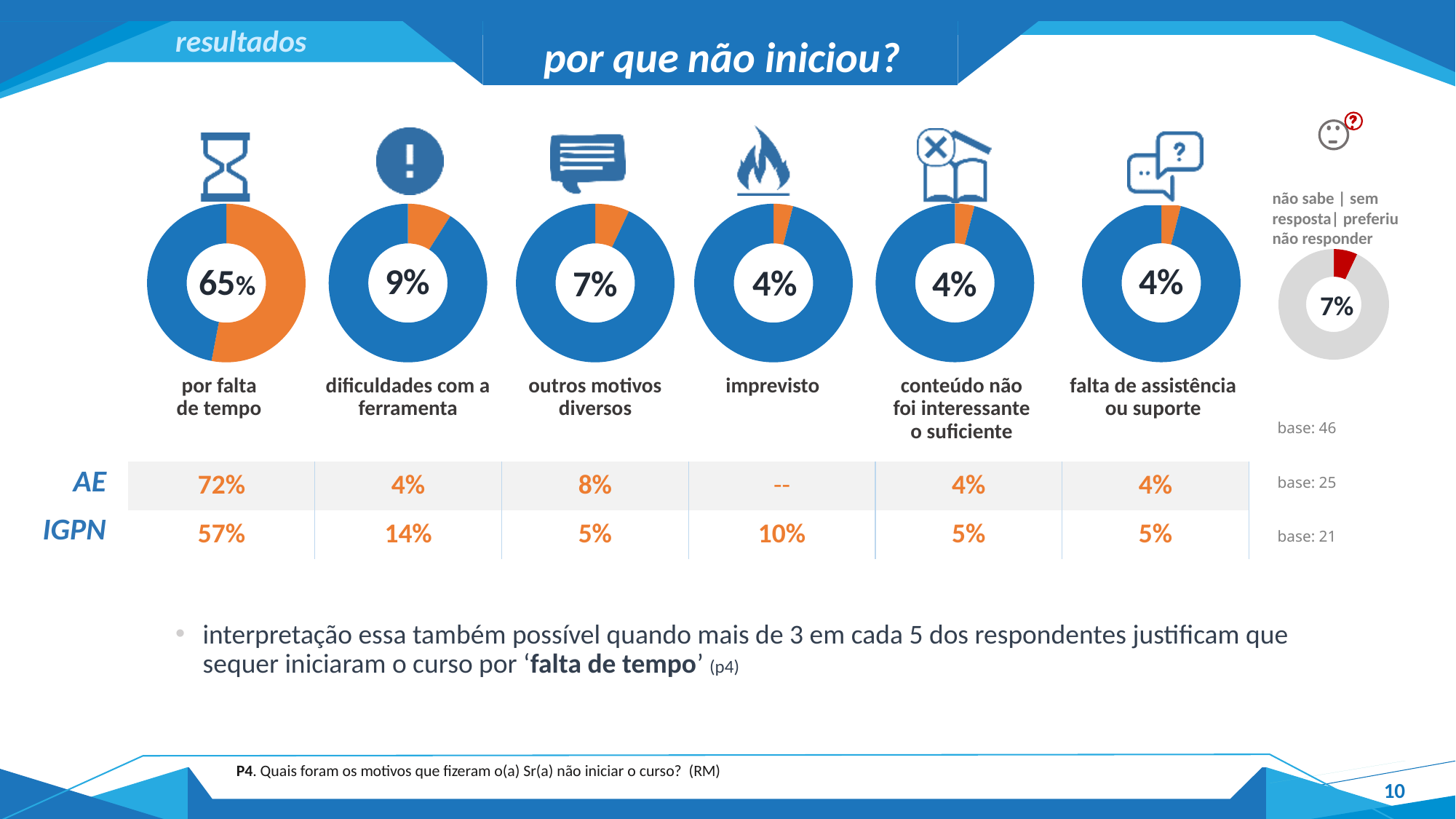
In the table below the charts, what is the IGPN value for 'dificuldades com a ferramenta'? 14% In the table below the charts, what is the AE value for 'por falta de tempo'? 72% What percentage is shown in the donut chart labelled 'outros motivos diversos'? 7% What is the difference between the percentages shown for 'por falta de tempo' and 'dificuldades com a ferramenta'? 56% What type of chart is used to display the percentages on this slide? donut chart What percentage is shown in the donut chart labelled 'por falta de tempo'? 65% What percentage is shown in the donut chart labelled 'imprevisto'? 4% How many donut charts are shown on the slide? 7 Which is larger: the percentage for 'dificuldades com a ferramenta' or for 'outros motivos diversos'? dificuldades com a ferramenta Which reason has the highest percentage among the donut charts? por falta de tempo What percentage is shown in the grey donut chart labelled 'não sabe | sem resposta | preferiu não responder'? 7% What percentage is shown in the donut chart labelled 'dificuldades com a ferramenta'? 9%